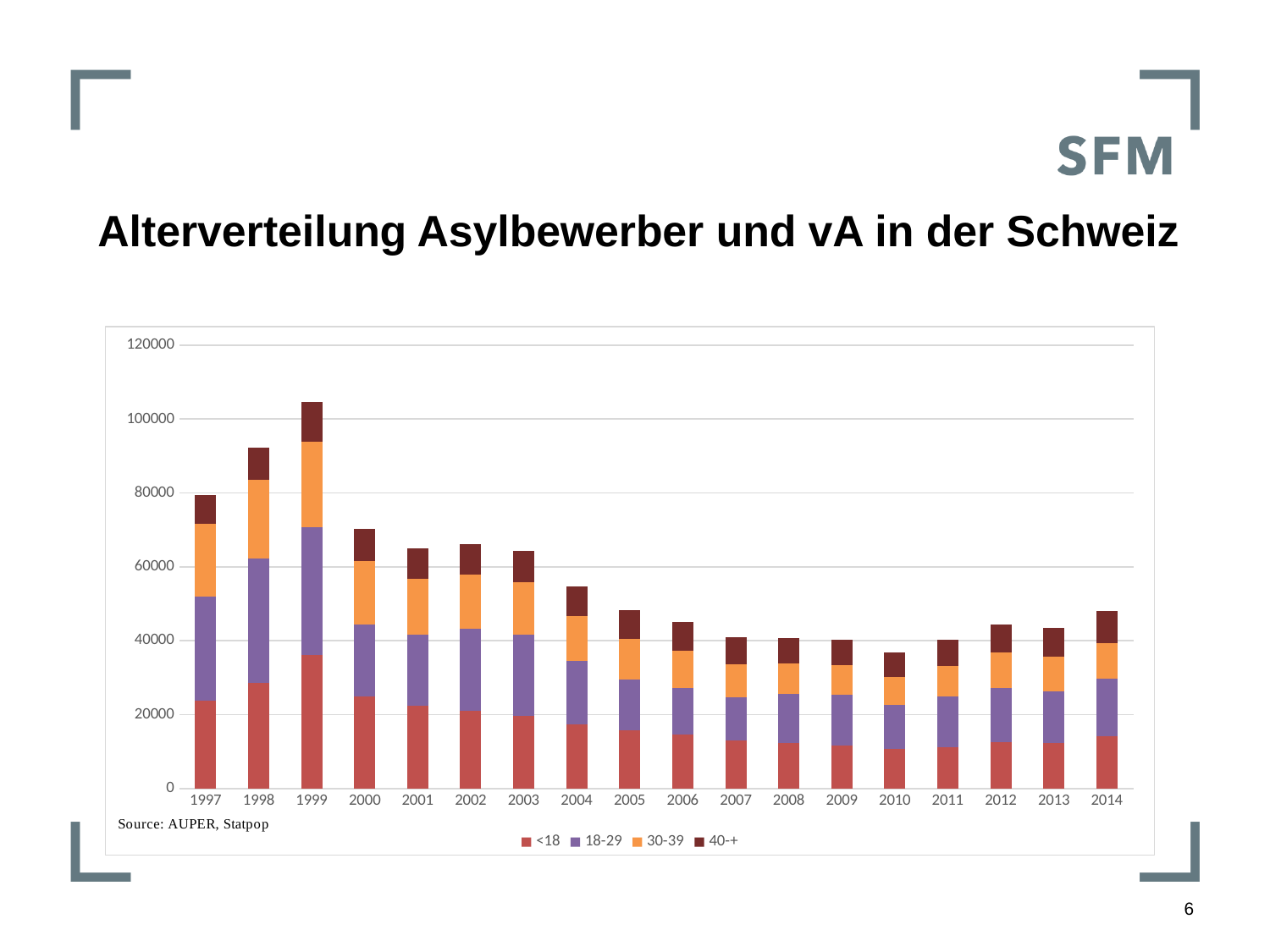
How many series does the chart's legend list? 4 Is the total value for 2010 greater or less than 40000? less What are the four age groups listed in the chart's legend? <18, 18-29, 30-39, 40-+ Is the total value for 1999 greater or less than 100000? greater How many years are shown along the x axis of the chart? 18 Do the total bar heights rise or fall from 1999 to 2010? Fall What kind of chart is shown on the slide? Stacked bar chart Is the total value for 2000 greater or less than 60000? greater Which year has the larger total bar, 2013 or 2014? 2014 Which year has the highest total bar in the chart? 1999 Which year has the lowest total bar in the chart? 2010